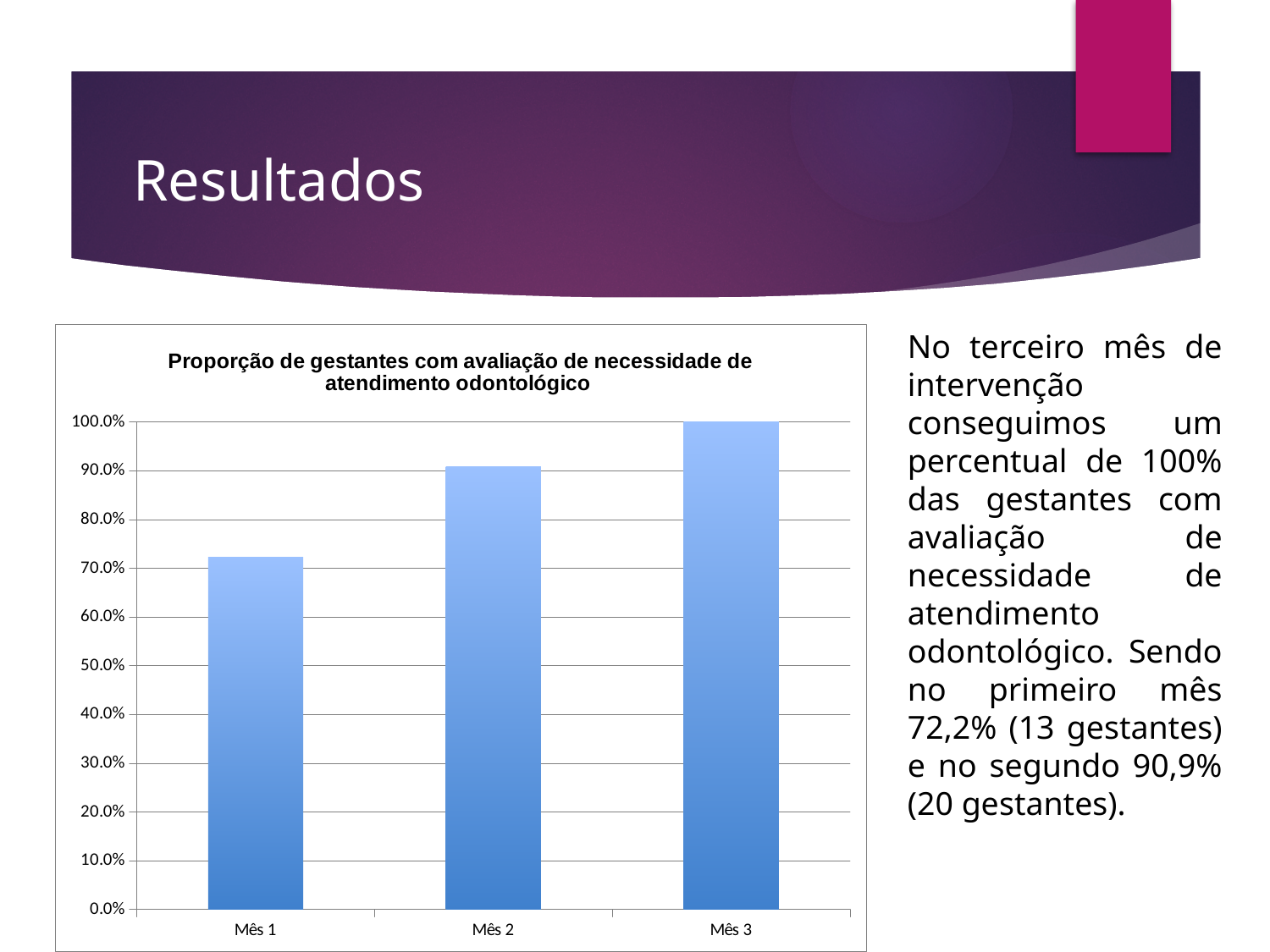
What is the highest value shown on the y axis of the chart? 100.0% What is the title of the chart? Proporção de gestantes com avaliação de necessidade de atendimento odontológico Do the values rise or fall from Mês 1 to Mês 3? rise Is the value for Mês 2 greater or less than 90.0%? greater Which month has the highest value in the chart? Mês 3 Is the value for Mês 1 greater or less than 80.0%? less What kind of chart is shown on the slide? bar chart Which month has the lowest value in the chart? Mês 1 How many categories are shown on the x axis of the chart? 3 Is the value for Mês 1 greater or less than 70.0%? greater What is the value for Mês 3 in the chart? 100.0% Which is larger, the value for Mês 1 or the value for Mês 2? Mês 2